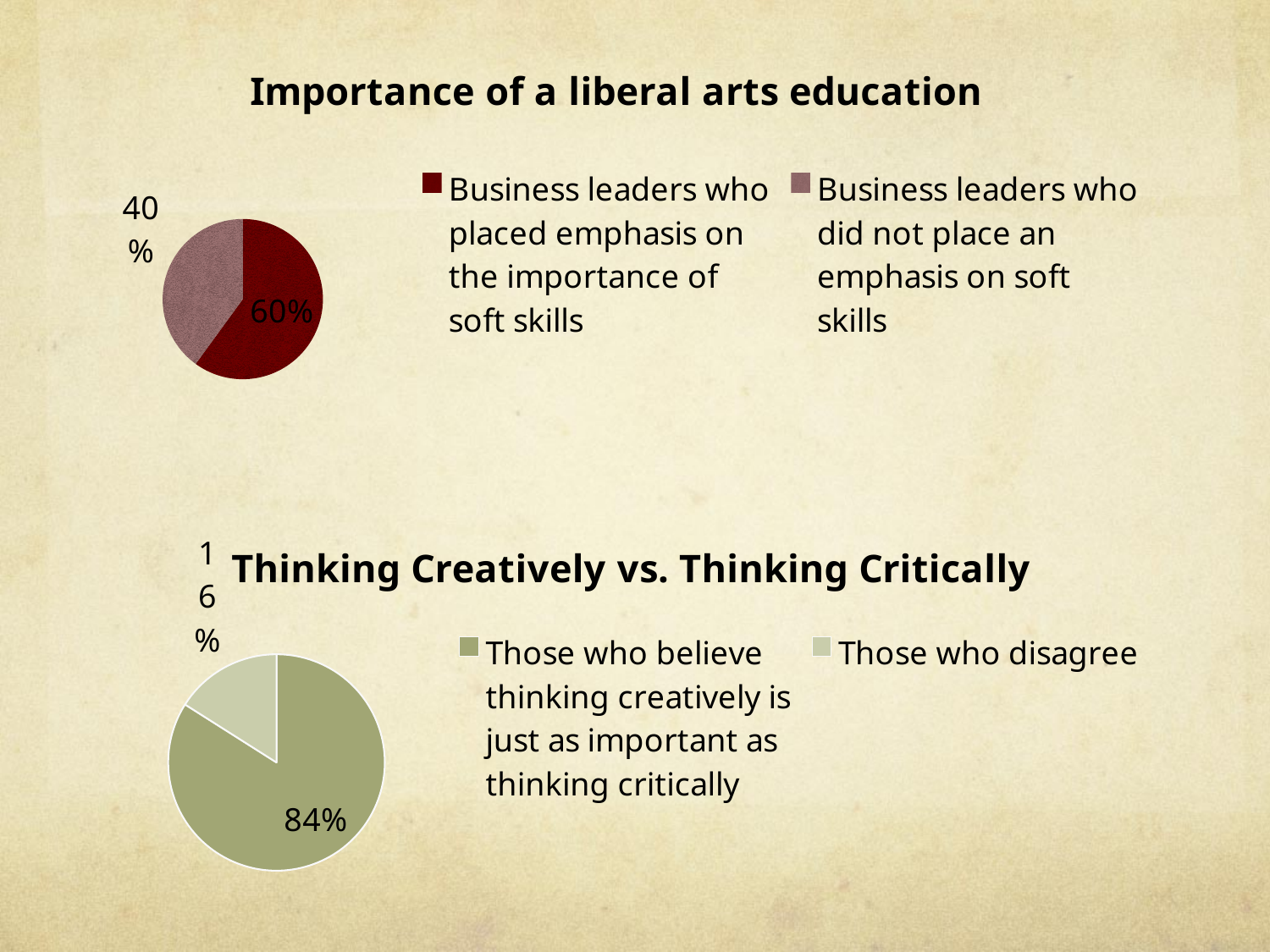
In the 'Thinking Creatively vs. Thinking Critically' chart, which slice is the smallest? Those who disagree How many entries does the legend of the 'Importance of a liberal arts education' chart list? 2 In the 'Importance of a liberal arts education' chart, which slice is the largest? Business leaders who placed emphasis on the importance of soft skills In the 'Importance of a liberal arts education' chart, what percentage of business leaders placed emphasis on the importance of soft skills? 60% In the 'Thinking Creatively vs. Thinking Critically' chart, what is the difference between the two slices? 68% In the 'Importance of a liberal arts education' chart, what is the difference between the two slices? 20% What kind of chart is the 'Importance of a liberal arts education' chart? Pie chart Which is larger: the 'Those who disagree' slice in the bottom chart or the 'did not place an emphasis on soft skills' slice in the top chart? Business leaders who did not place an emphasis on soft skills In the 'Importance of a liberal arts education' chart, what percentage of business leaders did not place an emphasis on soft skills? 40% In the 'Thinking Creatively vs. Thinking Critically' chart, what percentage disagree? 16% How many slices does the 'Thinking Creatively vs. Thinking Critically' pie chart have? 2 In the 'Thinking Creatively vs. Thinking Critically' chart, what percentage believe thinking creatively is just as important as thinking critically? 84%